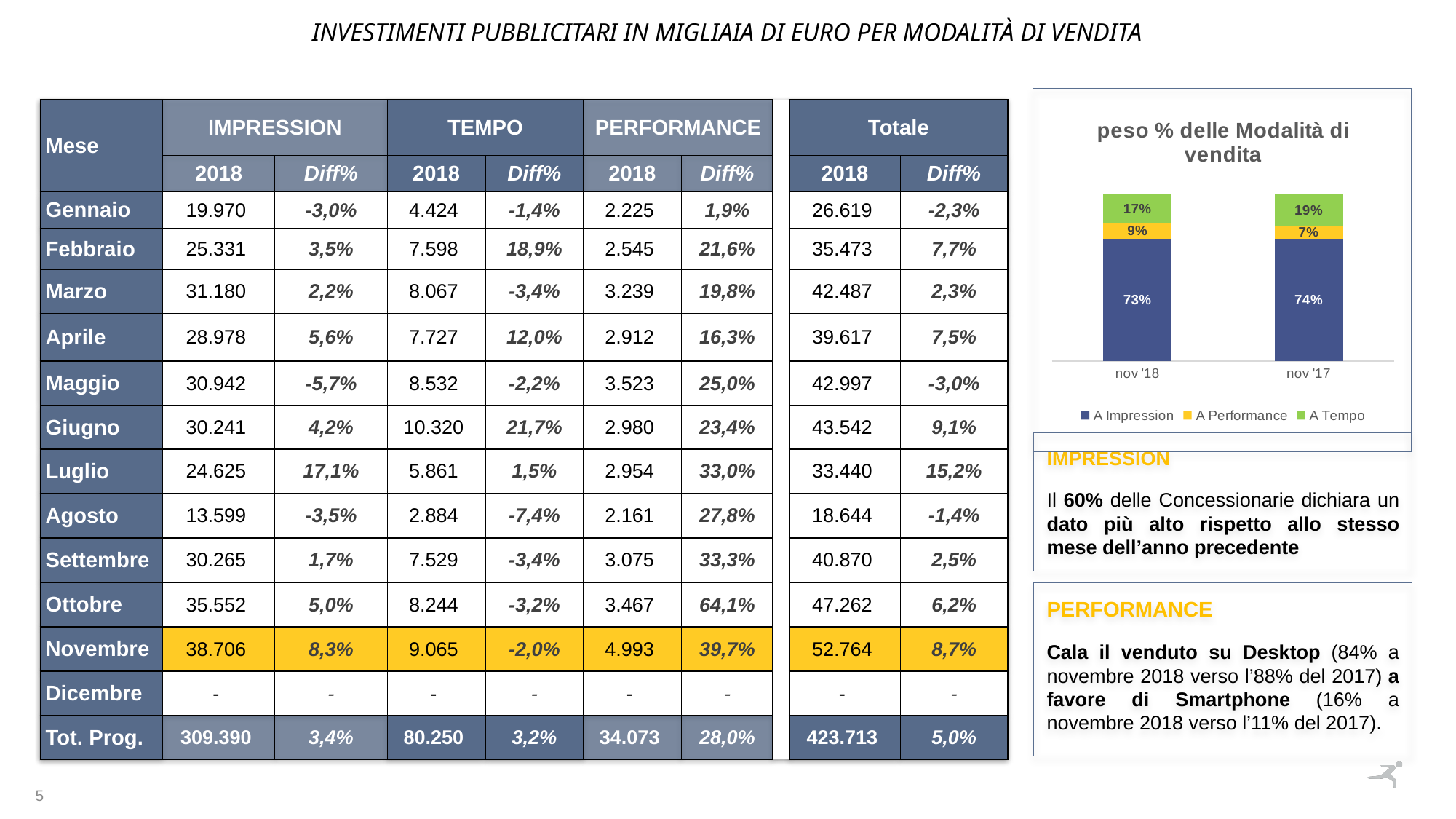
In the 'peso % delle Modalità di vendita' chart, what is the value for A Tempo in nov '17? 19% What colour represents A Tempo in the 'peso % delle Modalità di vendita' chart? green How many bars (categories) are shown in the 'peso % delle Modalità di vendita' chart? 2 In the 'peso % delle Modalità di vendita' chart, what is the value for A Impression in nov '17? 74% How many series does the legend of the 'peso % delle Modalità di vendita' chart list? 3 In the 'peso % delle Modalità di vendita' chart, is the A Tempo share larger in nov '18 or in nov '17? nov '17 In the 'peso % delle Modalità di vendita' chart, what is the difference between the A Performance share in nov '18 and in nov '17? 2% In the 'peso % delle Modalità di vendita' chart, what is the value for A Performance in nov '18? 9% In the 'peso % delle Modalità di vendita' chart, which series has the smallest share in nov '17? A Performance In the 'peso % delle Modalità di vendita' chart, what is the value for A Impression in nov '18? 73% What kind of chart is shown on the right of the slide under the title 'peso % delle Modalità di vendita'? stacked bar chart In the 'peso % delle Modalità di vendita' chart, which series has the largest share in nov '18? A Impression